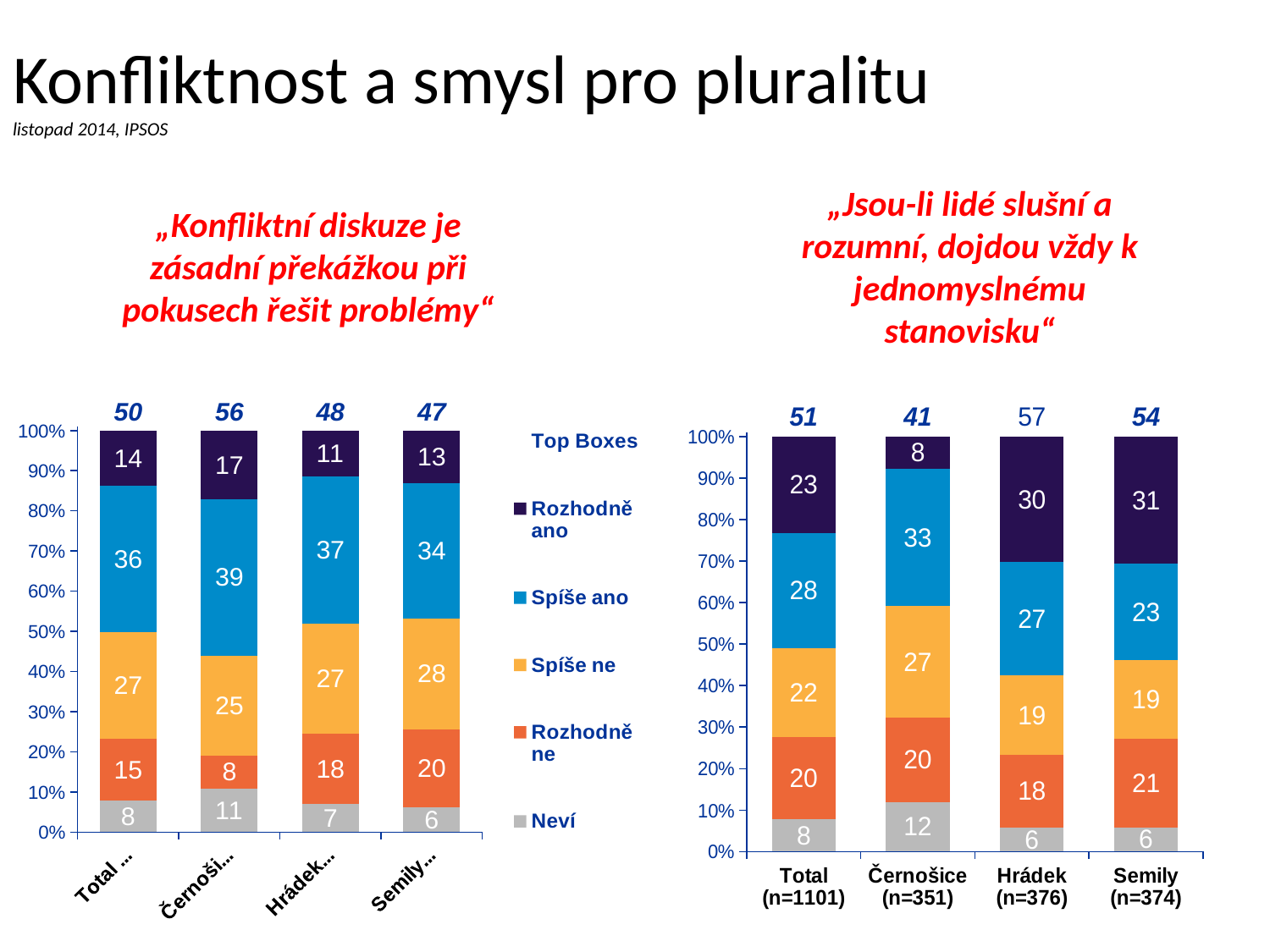
How many categories are shown on the x axis of the right chart ("Jsou-li lidé slušní a rozumní...")? 4 How many series does the legend list? 6 In the left chart ("Konfliktní diskuze je zásadní překážkou..."), what is the Top Boxes value shown above the Hrádek bar? 48 In the right chart ("Jsou-li lidé slušní a rozumní..."), is the "Rozhodně ne" value larger for Semily (n=374) or for Hrádek (n=376)? Semily (n=374) In the left chart ("Konfliktní diskuze je zásadní překážkou..."), what is the value of "Spíše ne" for Total? 27 In the right chart ("Jsou-li lidé slušní a rozumní..."), which category has the highest Top Boxes value? Hrádek (n=376) In the left chart ("Konfliktní diskuze je zásadní překážkou..."), what is the difference between the "Spíše ano" values for Černošice and Semily? 5 In the right chart ("Jsou-li lidé slušní a rozumní..."), what is the value of "Spíše ano" for Černošice (n=351)? 33 What kind of chart is the left chart ("Konfliktní diskuze je zásadní překážkou...")? Stacked bar chart In the right chart ("Jsou-li lidé slušní a rozumní..."), what is the value of "Rozhodně ano" for Hrádek (n=376)? 30 In the right chart ("Jsou-li lidé slušní a rozumní..."), which category has the lowest "Rozhodně ano" value? Černošice (n=351) In the right chart ("Jsou-li lidé slušní a rozumní..."), what is the Top Boxes value shown above the Total (n=1101) bar? 51